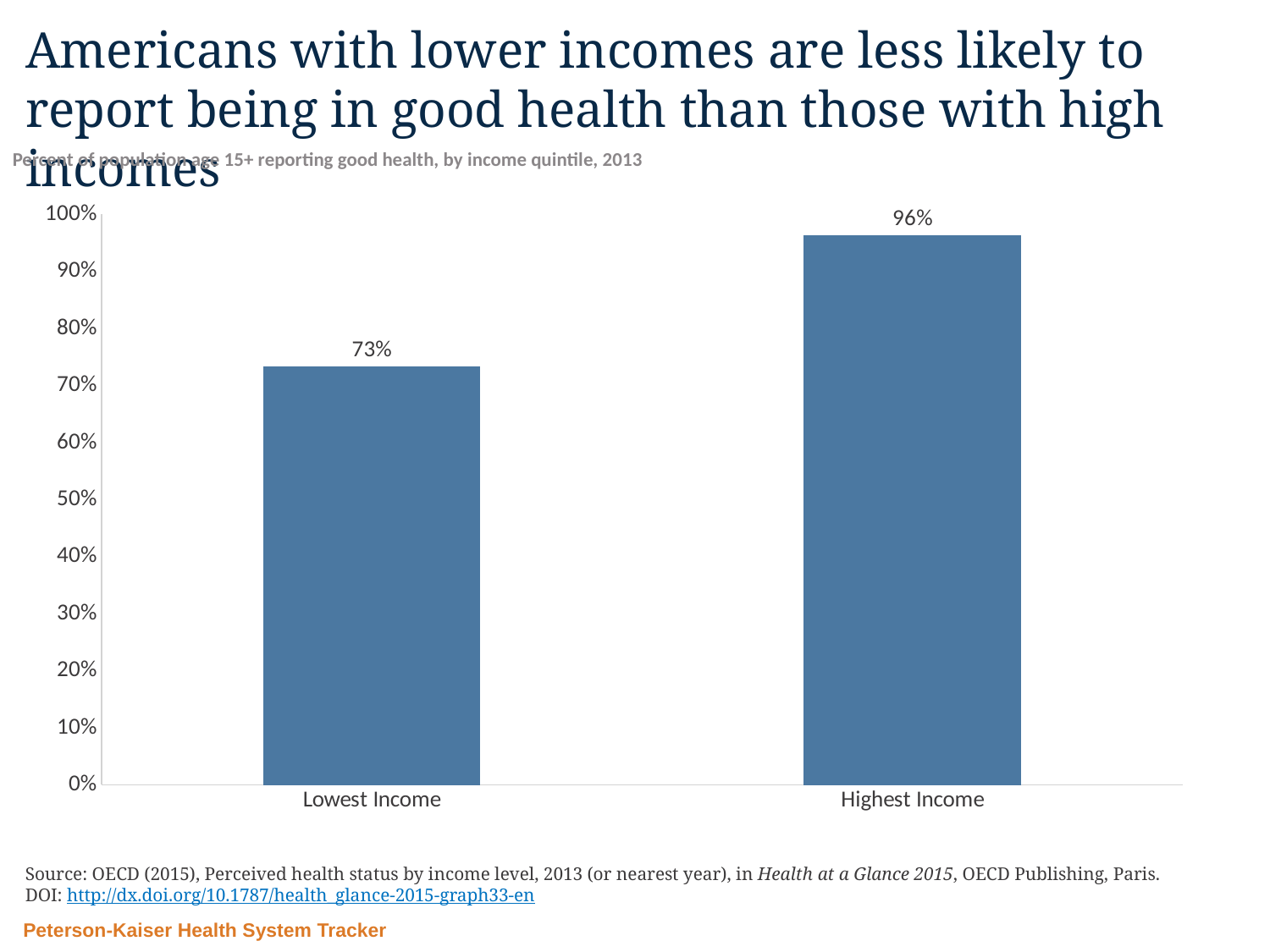
What is the maximum value shown on the vertical axis? 100% What percent of the highest income quintile reports good health? 96% What is the difference in percentage points between the Highest Income and Lowest Income groups? 23 percentage points Is the value for Lowest Income greater or less than 80%? less What year does the chart's data refer to, according to the chart subtitle? 2013 Which income group has the lower share reporting good health? Lowest Income Which income group has the higher share reporting good health? Highest Income Do the values rise or fall from Lowest Income to Highest Income? Rise What type of chart is shown on the slide? Bar chart How many income groups are shown in the chart? 2 Is the value for Highest Income greater or less than 90%? greater What percent of the lowest income quintile reports good health? 73%